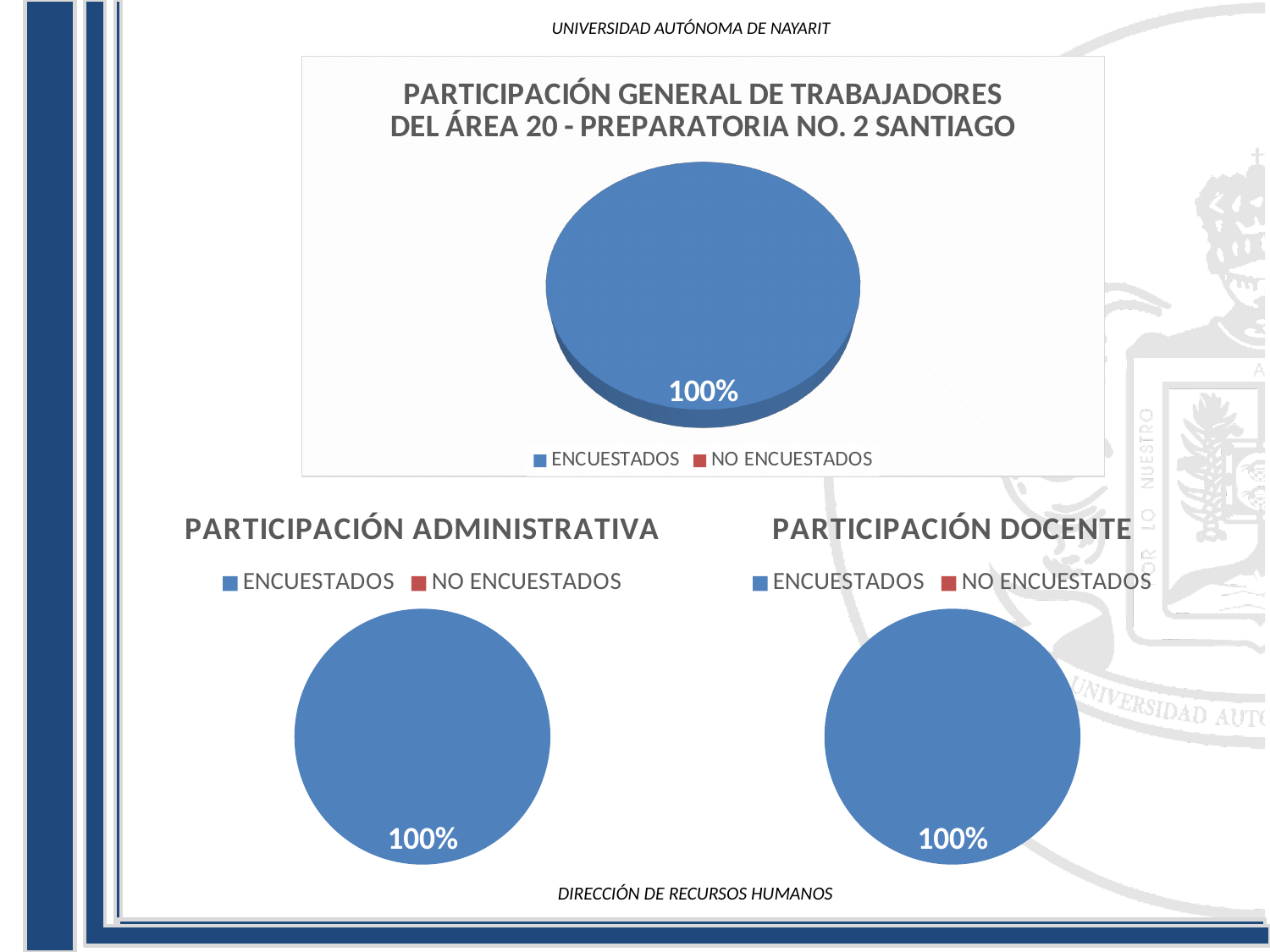
In the 'PARTICIPACIÓN ADMINISTRATIVA' chart, what percentage is shown on the pie? 100% How many entries does the legend of the 'PARTICIPACIÓN DOCENTE' chart list? 2 How many entries does the legend of the 'PARTICIPACIÓN GENERAL DE TRABAJADORES DEL ÁREA 20 - PREPARATORIA NO. 2 SANTIAGO' chart list? 2 What are the two legend entries in the 'PARTICIPACIÓN ADMINISTRATIVA' chart? ENCUESTADOS and NO ENCUESTADOS In the chart titled 'PARTICIPACIÓN GENERAL DE TRABAJADORES DEL ÁREA 20 - PREPARATORIA NO. 2 SANTIAGO', what share of the pie is ENCUESTADOS? 100% What kind of chart is the 'PARTICIPACIÓN GENERAL DE TRABAJADORES DEL ÁREA 20 - PREPARATORIA NO. 2 SANTIAGO' chart? Pie chart What kind of chart is the 'PARTICIPACIÓN DOCENTE' chart? Pie chart In the 'PARTICIPACIÓN DOCENTE' chart, what share of the pie is ENCUESTADOS? 100% In the 'PARTICIPACIÓN DOCENTE' chart, which category is larger, ENCUESTADOS or NO ENCUESTADOS? ENCUESTADOS What colour represents ENCUESTADOS in the 'PARTICIPACIÓN GENERAL DE TRABAJADORES DEL ÁREA 20 - PREPARATORIA NO. 2 SANTIAGO' chart? Blue In the 'PARTICIPACIÓN ADMINISTRATIVA' chart, which category makes up the whole pie? ENCUESTADOS How many pie charts are shown on the slide? 3